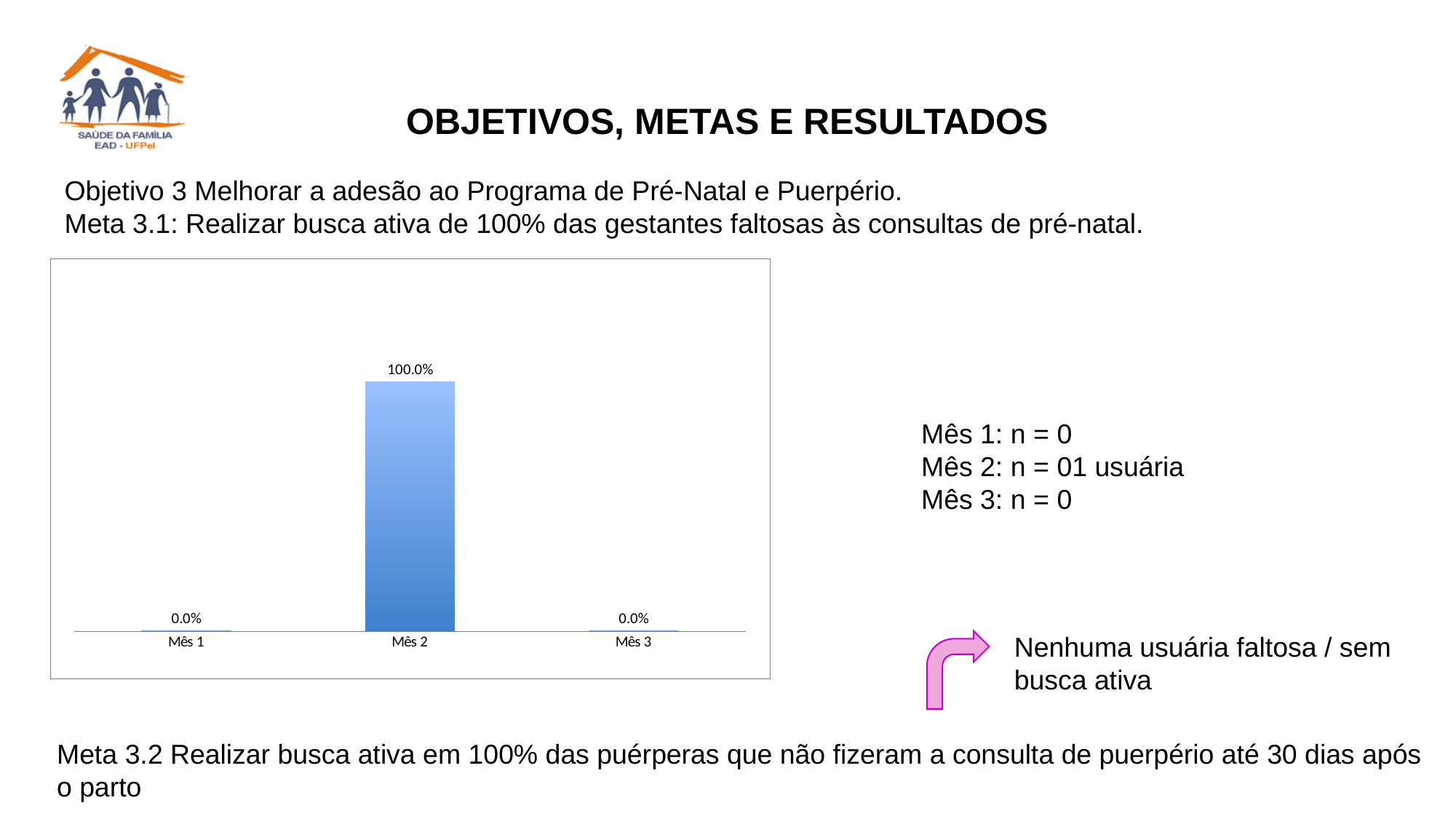
Which month has the highest value in the chart? Mês 2 Do the values rise or fall from Mês 1 to Mês 2? Rise Which is larger, the value for Mês 2 or the value for Mês 3? Mês 2 What is the value shown for Mês 3 in the chart? 0.0% What colour are the bars in the chart? Blue What is the difference between the values for Mês 2 and Mês 1? 100.0% What is the value shown for Mês 1 in the chart? 0.0% Do the values rise or fall from Mês 2 to Mês 3? Fall What kind of chart is shown on the slide? Bar chart How many categories are plotted in the chart? 3 What is the label of the first category on the x axis of the chart? Mês 1 What is the value shown for Mês 2 in the chart? 100.0%